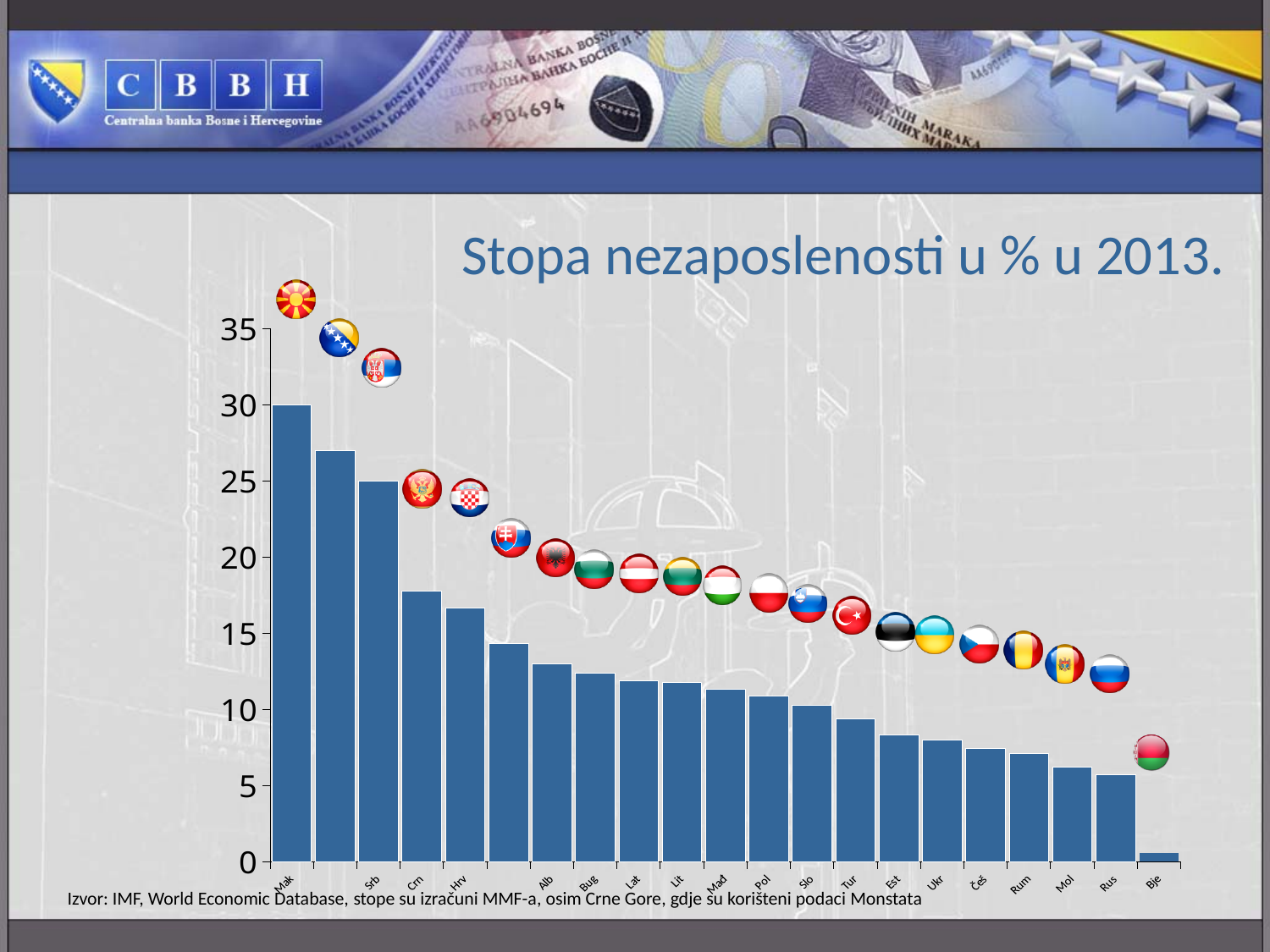
Which category has the lowest unemployment rate in the chart? Bje Is the value for Bje greater or less than 5? less Which is larger, the value for Mak or the value for Srb? Mak Is the value for Crn greater or less than 20? less Is the value for Tur greater or less than 10? less What kind of chart is shown on the slide? bar chart Which is larger, the value for Hrv or the value for Alb? Hrv Do the values rise or fall moving from left to right along the x axis? fall What is the title of the chart? Stopa nezaposlenosti u % u 2013. Which category has the highest unemployment rate in the chart? Mak How many bars are plotted in the chart? 21